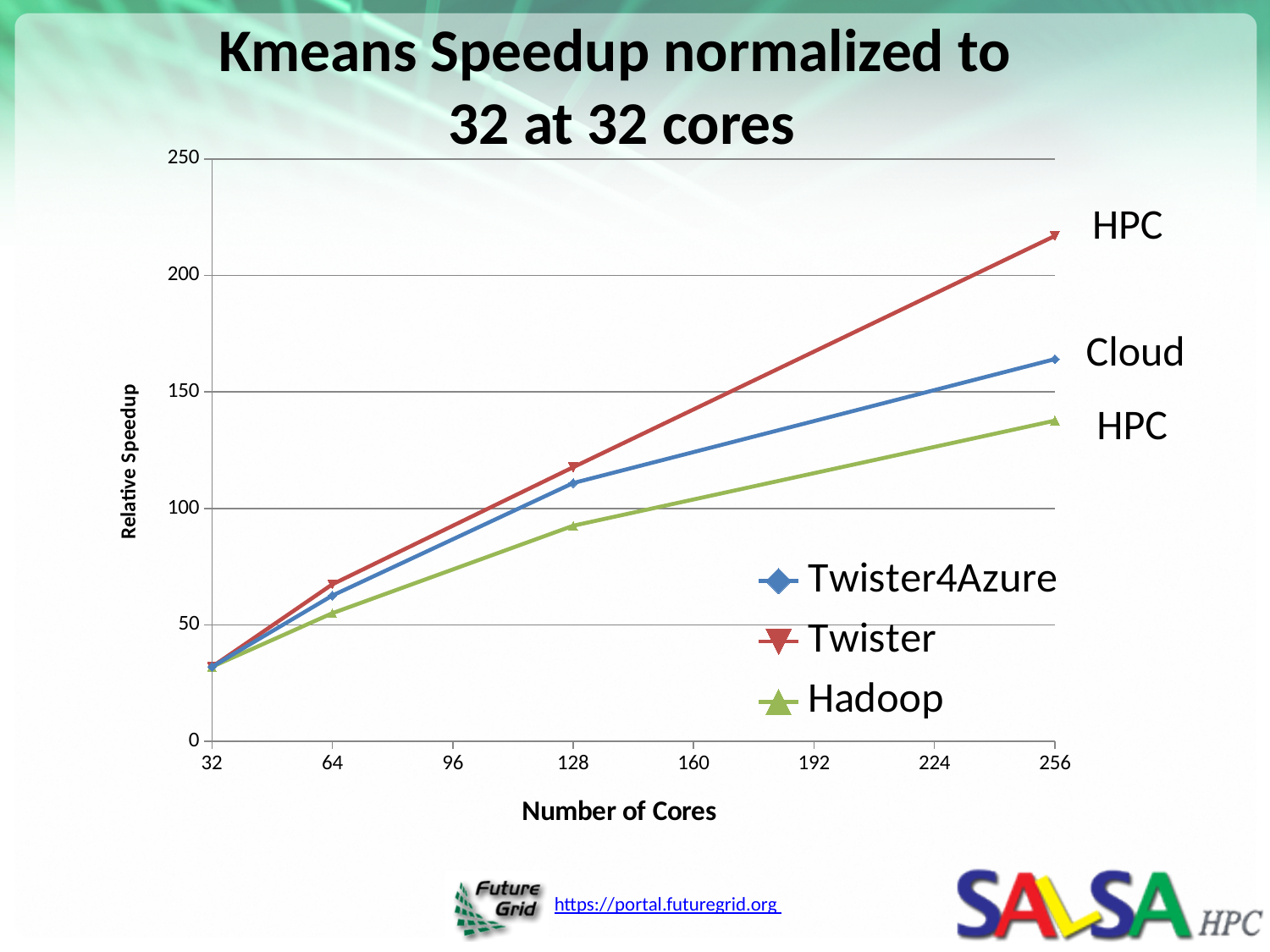
Which series has the highest relative speedup at 256 cores? Twister Do the relative speedup values rise or fall as the number of cores increases? rise Is the relative speedup for Twister4Azure at 256 cores greater or less than 150? greater How many series does the legend list? 3 Is the relative speedup for Hadoop at 256 cores greater or less than 150? less Which series has the lowest relative speedup at 256 cores? Hadoop Is the relative speedup for Twister at 256 cores greater or less than 200? greater How many data points are plotted for each series? 4 What kind of chart is shown on the slide? line chart At 128 cores, which series has the larger relative speedup, Twister or Hadoop? Twister What is the label of the x axis? Number of Cores